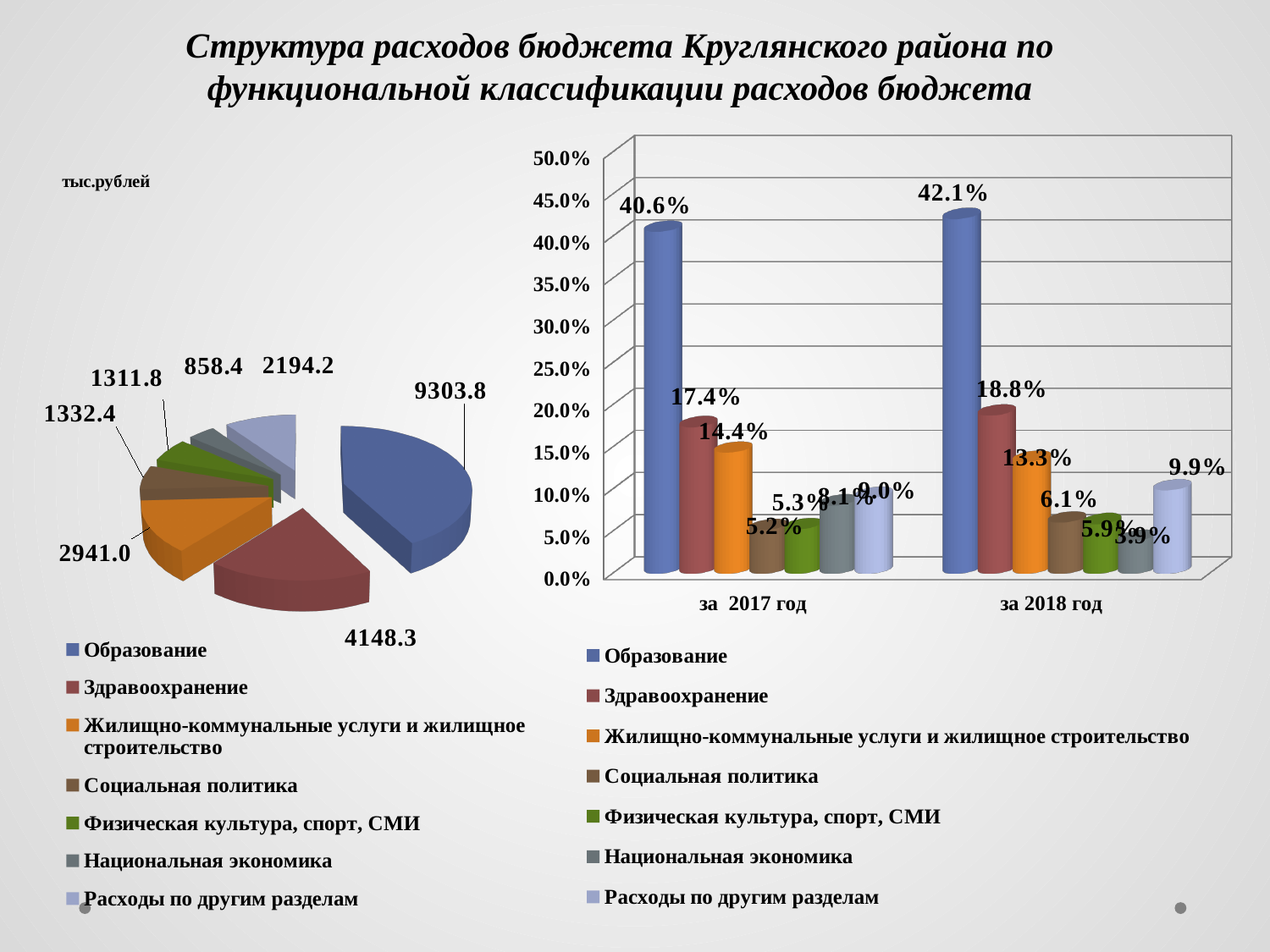
On the pie chart on the left, which category has the smallest value? Национальная экономика What type of chart is shown on the right side of the slide? bar chart On the pie chart on the left, what is the difference between the values for Образование and Здравоохранение? 5155.5 On the pie chart on the left, what is the value for Здравоохранение? 4148.3 On the bar chart on the right, which is larger: Жилищно-коммунальные услуги и жилищное строительство за 2017 год or за 2018 год? за 2017 год On the bar chart on the right, what is the value for Здравоохранение за 2017 год? 17.4% On the pie chart on the left, how many categories are shown? 7 On the bar chart on the right, what is the value for Образование за 2018 год? 42.1% On the bar chart on the right, how many series does the legend list? 7 On the pie chart on the left, what is the value for Образование? 9303.8 On the bar chart on the right, what is the value for Расходы по другим разделам за 2018 год? 9.9% On the pie chart on the left, which category has the largest value? Образование